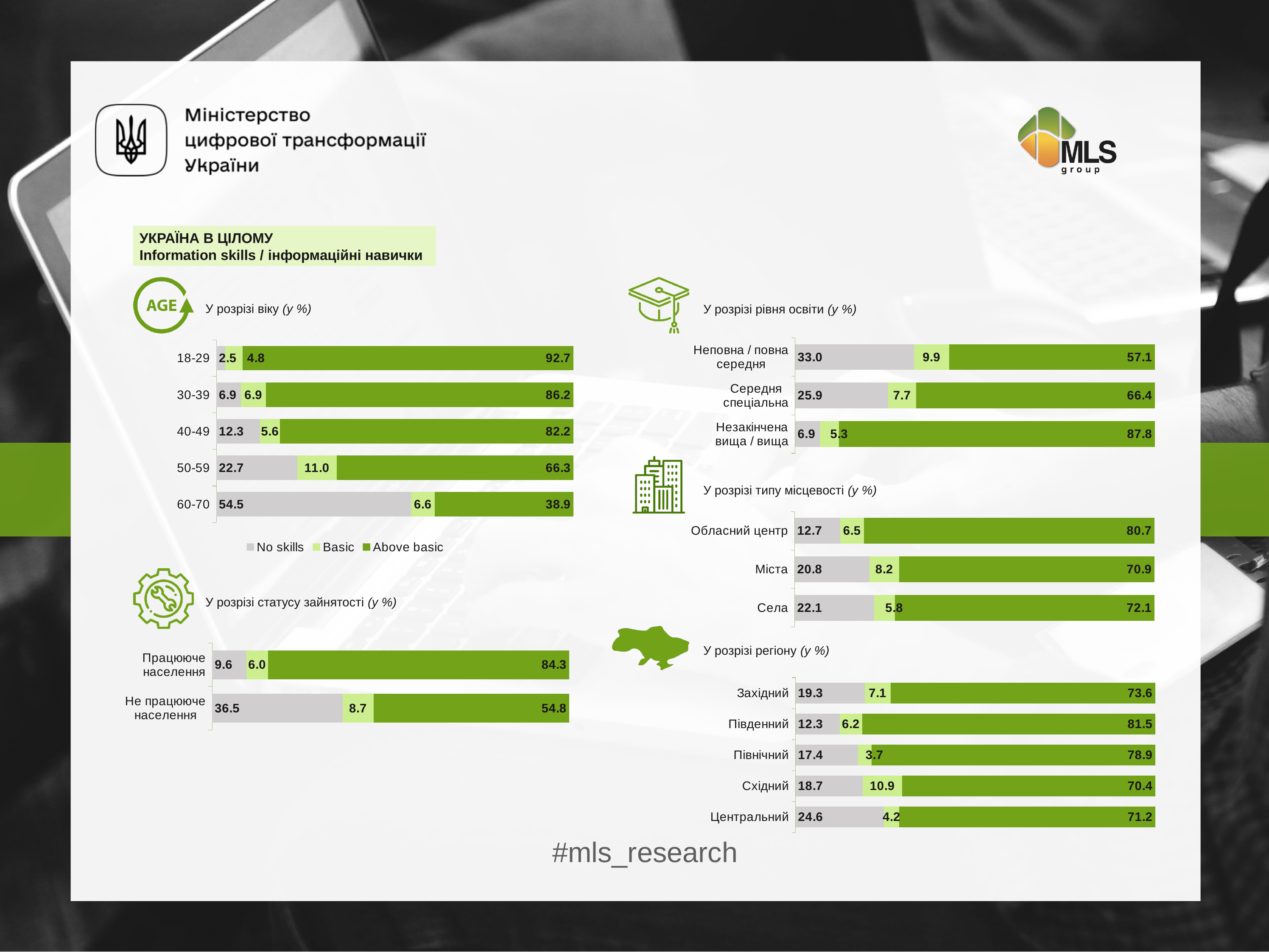
In the age chart (У розрізі віку), which age group has the highest No skills value? 60-70 In the education level chart (У розрізі рівня освіти), which category has the lowest Above basic value? Неповна / повна середня How many series does the legend list for the age chart (У розрізі віку)? 3 In the employment status chart (У розрізі статусу зайнятості), what is the No skills value for Не працююче населення? 36.5 In the region chart (У розрізі регіону), what is the Basic value for Східний? 10.9 What kind of chart is the age chart (У розрізі віку)? Stacked bar chart In the locality type chart (У розрізі типу місцевості), which has the larger Above basic value, Міста or Села? Села In the age chart (У розрізі віку), what is the Above basic value for the 18-29 group? 92.7 In the education level chart (У розрізі рівня освіти), what is the Basic value for Середня спеціальна? 7.7 In the age chart (У розрізі віку), how many age groups are shown? 5 In the region chart (У розрізі регіону), which region has the highest Above basic value? Південний In the employment status chart (У розрізі статусу зайнятості), what is the difference in Above basic values between Працююче населення and Не працююче населення? 29.5